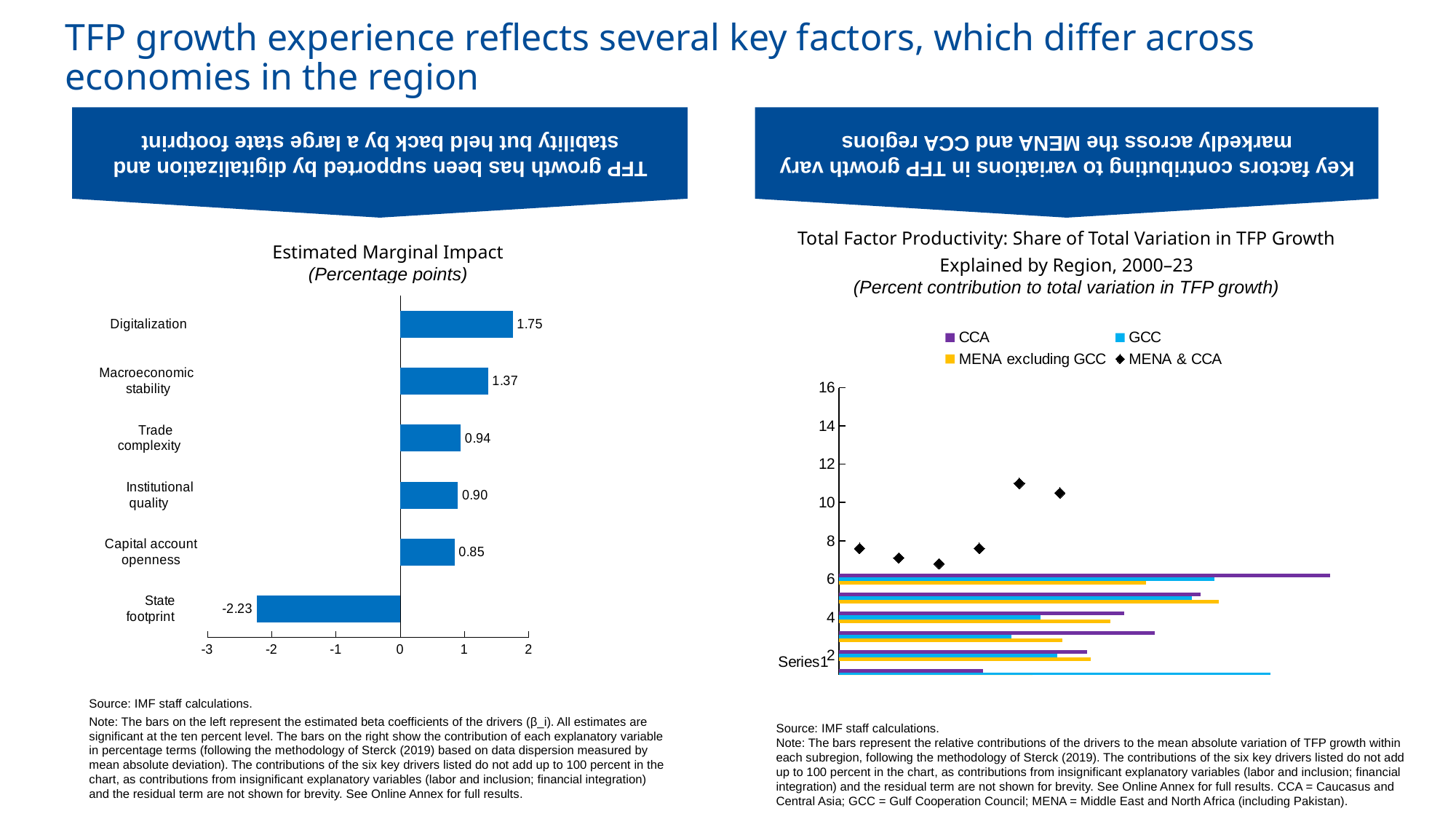
What kind of chart is the Estimated Marginal Impact chart? Bar chart In the Estimated Marginal Impact chart, what is the value for State footprint? -2.23 In the Estimated Marginal Impact chart, how many categories are shown? 6 In the Estimated Marginal Impact chart, what is the value for Digitalization? 1.75 In the Estimated Marginal Impact chart, which is larger: the value for Trade complexity or the value for Capital account openness? Trade complexity In the Estimated Marginal Impact chart, how many categories have a negative value? 1 In the Total Factor Productivity chart on the right, how many series does the legend list? 4 In the Estimated Marginal Impact chart, which category has the highest value? Digitalization In the Estimated Marginal Impact chart, what is the difference between the values for Digitalization and Macroeconomic stability? 0.38 In the Estimated Marginal Impact chart, what is the value for Institutional quality? 0.90 In the Estimated Marginal Impact chart, what is the value for Macroeconomic stability? 1.37 In the Estimated Marginal Impact chart, which category has the lowest value? State footprint